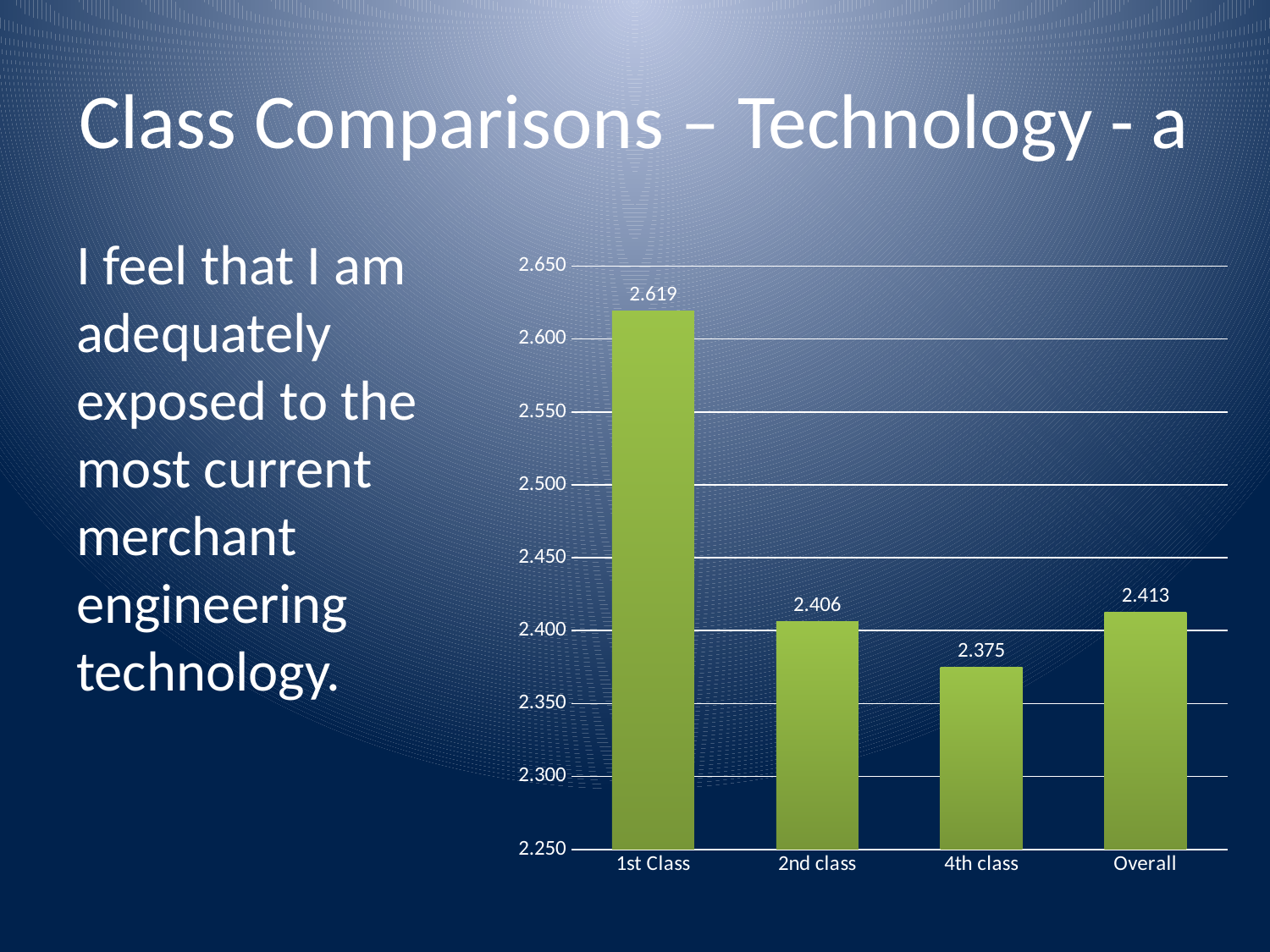
What is the difference between the values for Overall and 2nd class? 0.007 How many categories are shown on the x axis? 4 What is the value for 2nd class? 2.406 Which category has the highest value? 1st Class Is the value for 1st Class greater or less than 2.600? greater What is the difference between the values for 1st Class and 4th class? 0.244 What is the value for Overall? 2.413 Which category has the lowest value? 4th class Which is larger, the value for 2nd class or the value for 4th class? 2nd class What is the value for 4th class? 2.375 What is the value for 1st Class? 2.619 What kind of chart is shown on the slide? bar chart